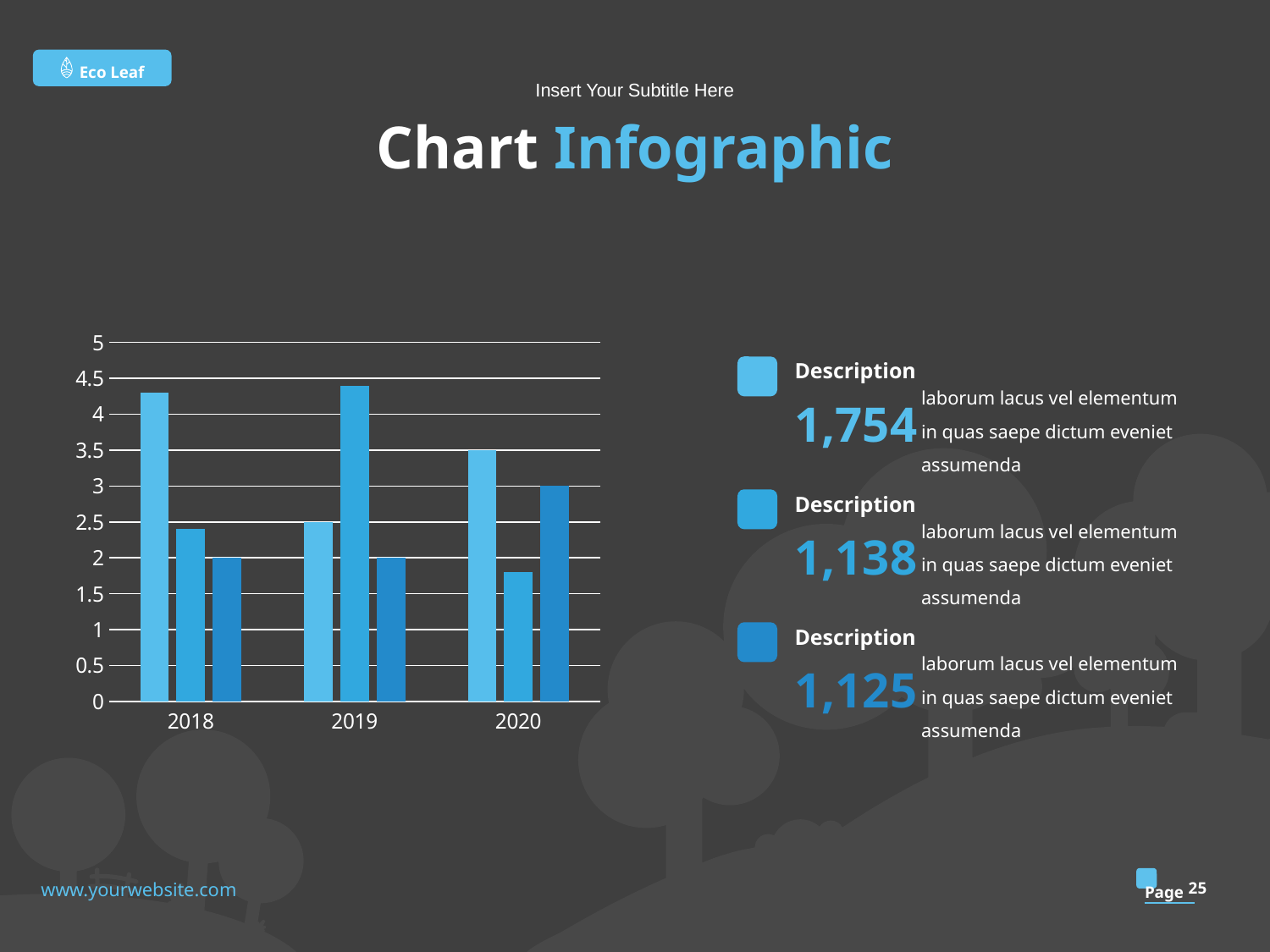
Is the value of the tallest bar for 2019 greater or less than 4? greater What is the highest value shown on the y axis of the chart? 5 Is the value of the middle (second) bar for 2018 greater or less than 2? greater What kind of chart is shown on the slide? bar chart Which years are shown on the x axis of the chart? 2018, 2019, 2020 Is the value of the shortest bar for 2020 greater or less than 2? less How many bars are shown for each year in the chart? 3 For 2020, which is larger: the first (lightest blue) bar or the third (darkest blue) bar? the first (lightest blue) bar For 2020, which of the three bars is the shortest? the second (middle) bar For 2018, which of the three bars is the tallest? the first (lightest blue) bar How many categories are shown on the x axis of the chart? 3